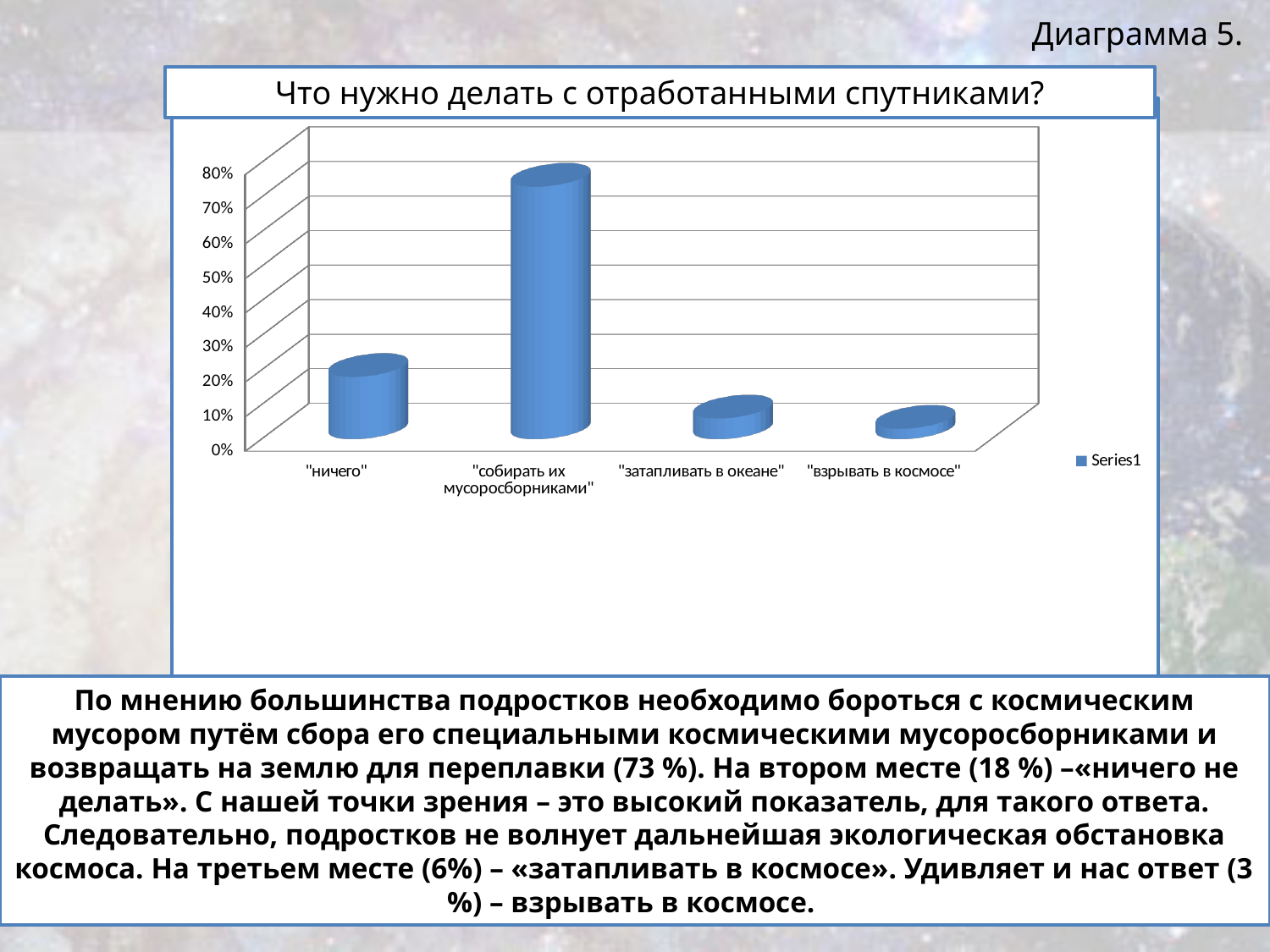
How many series does the chart legend list? 1 Is the value for "ничего" greater or less than 30%? less Which is larger, the value for "затапливать в океане" or the value for "взрывать в космосе"? "затапливать в океане" Which category has the lowest bar? "взрывать в космосе" What is the title of the chart? Что нужно делать с отработанными спутниками? Which is larger, the value for "ничего" or the value for "затапливать в океане"? "ничего" How many categories are shown on the x axis of the chart? 4 What kind of chart is shown on the slide? bar chart Is the value for "собирать их мусоросборниками" greater or less than 70%? greater Which category has the highest bar? "собирать их мусоросборниками" What is the name of the series shown in the legend? Series1 Is the value for "затапливать в океане" greater or less than 10%? less